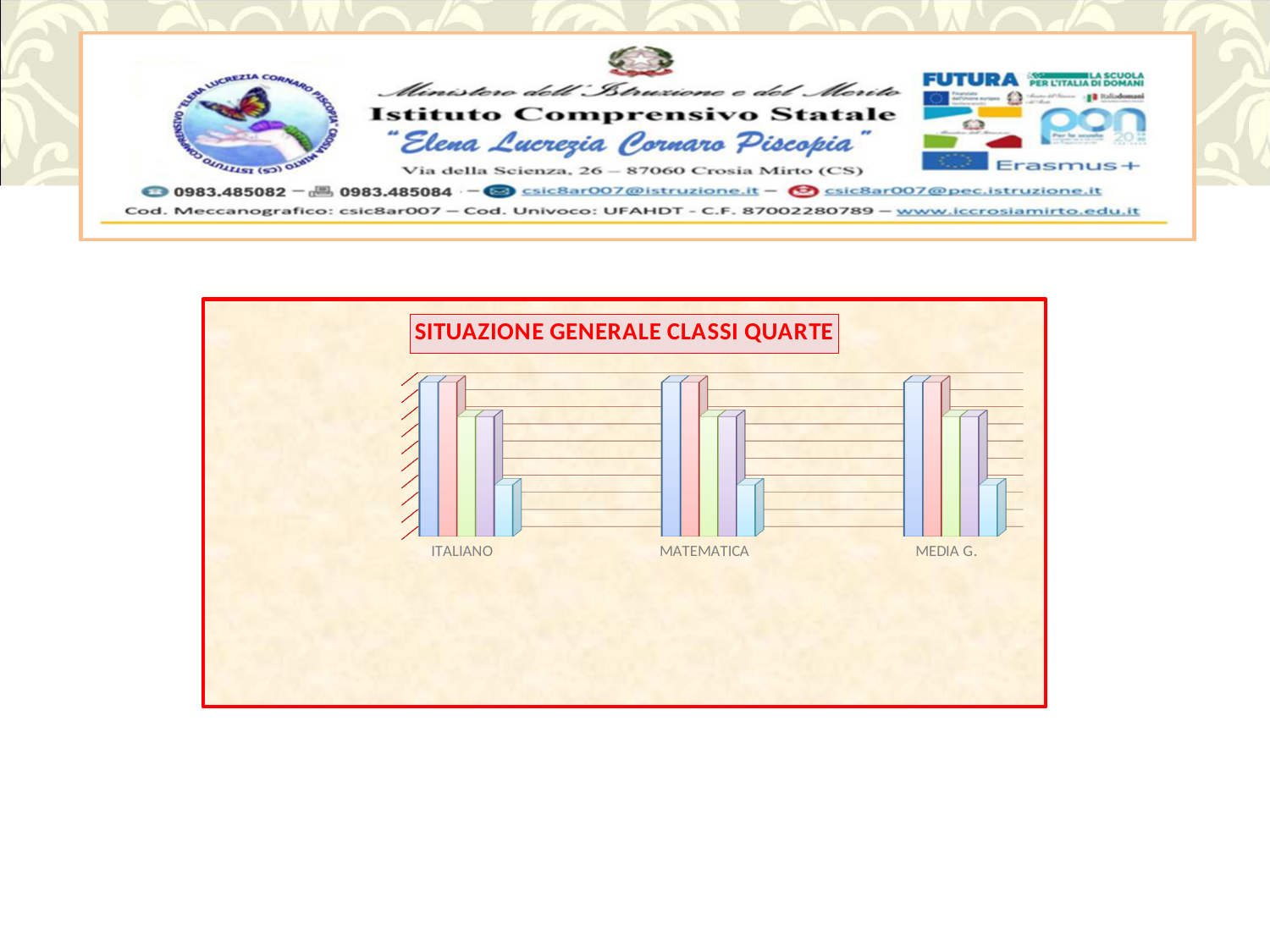
What is the title of the chart? SITUAZIONE GENERALE CLASSI QUARTE In the MATEMATICA group, which bar is the shortest: the first (blue) bar or the last (light blue) bar? the last (light blue) bar In the ITALIANO group, is the first (blue) bar taller or shorter than the last (light blue) bar? taller How many bars are plotted for the ITALIANO category? 5 What are the category labels on the x axis of the chart? ITALIANO, MATEMATICA, MEDIA G. In the MEDIA G. group, is the second (pink) bar taller or shorter than the third (green) bar? taller What kind of chart is shown on the slide? bar chart Does the chart display a legend? No How many categories are shown on the x axis of the chart? 3